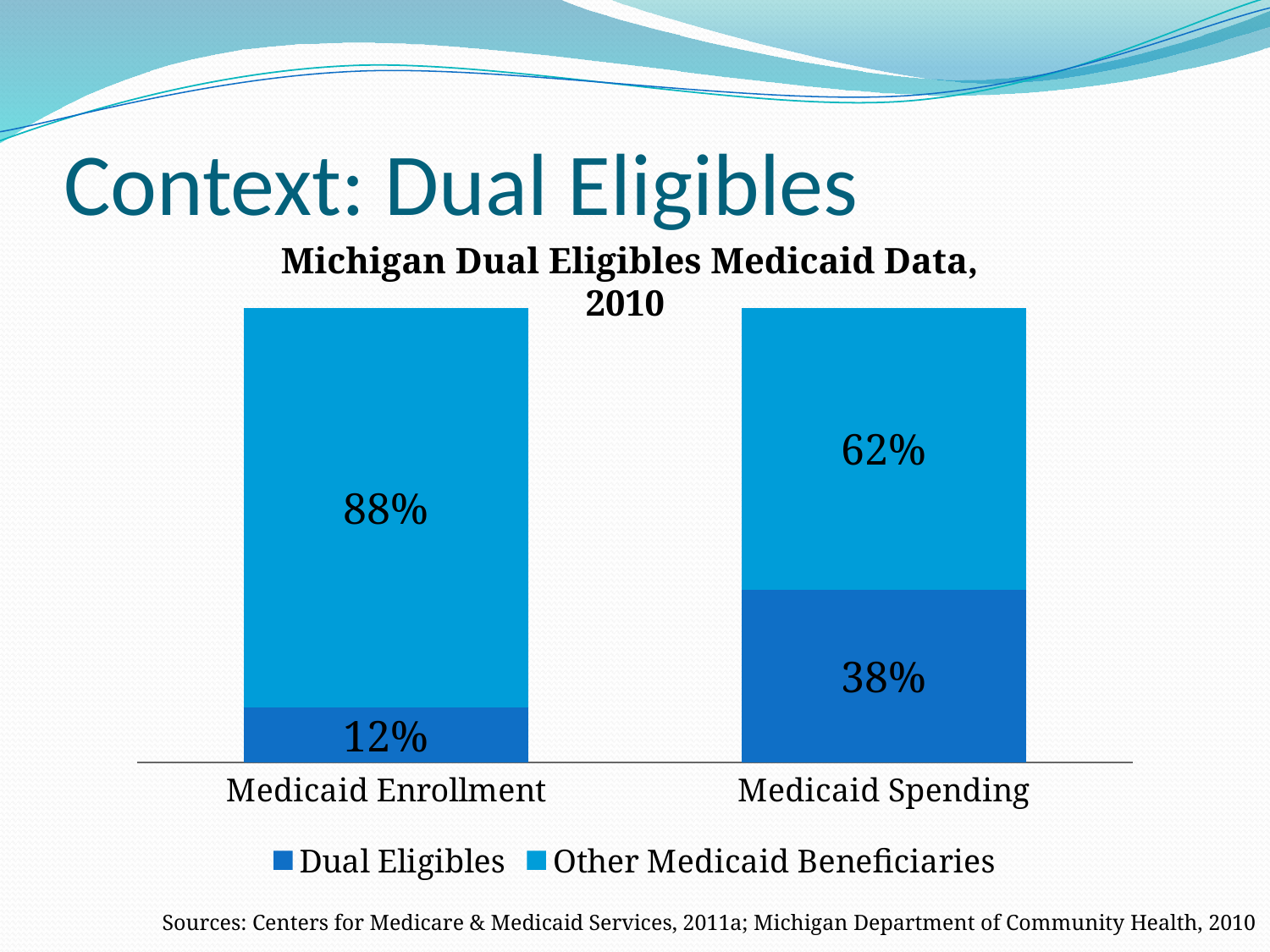
What is the difference between the Dual Eligibles values for Medicaid Spending and Medicaid Enrollment? 26% What is the value for Other Medicaid Beneficiaries in Medicaid Spending? 62% What kind of chart is shown? Stacked bar chart What is the value for Other Medicaid Beneficiaries in Medicaid Enrollment? 88% How many series does the legend list? 2 In which category is the Dual Eligibles value highest? Medicaid Spending What is the value for Dual Eligibles in Medicaid Spending? 38% What is the value for Dual Eligibles in Medicaid Enrollment? 12% Which is larger: Dual Eligibles in Medicaid Spending or Other Medicaid Beneficiaries in Medicaid Spending? Other Medicaid Beneficiaries in Medicaid Spending How many categories are shown on the x axis? 2 In which category is the Other Medicaid Beneficiaries value lowest? Medicaid Spending What is the title of the chart? Michigan Dual Eligibles Medicaid Data, 2010